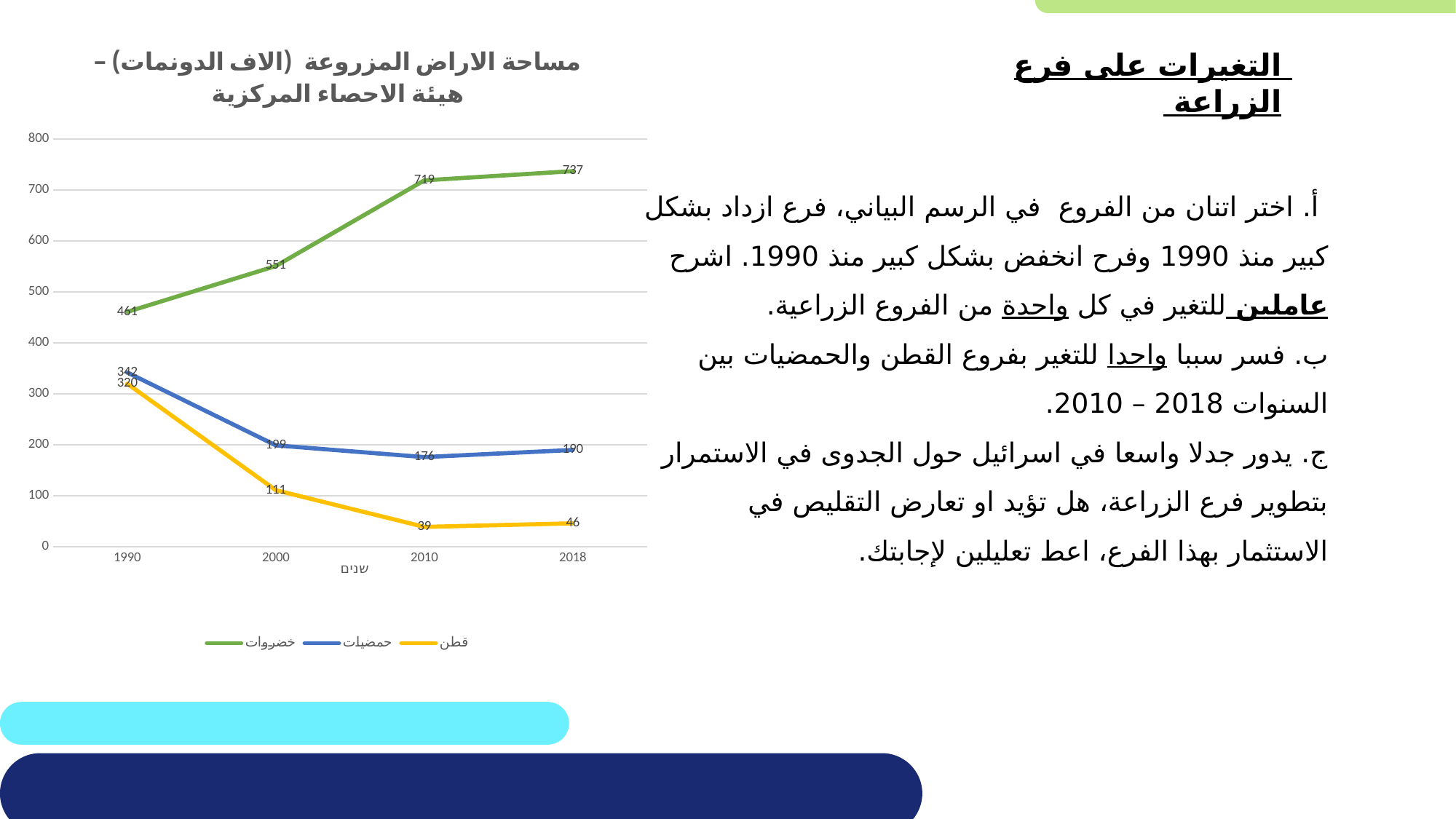
What is the value for حمضيات in 2000? 199 What is the value for قطن in 2010? 39 What is the value for خضروات in 2018? 737 What kind of chart is shown on the slide? Line chart Which series has the larger value in 1990, حمضيات or قطن? حمضيات In which year is the value for قطن lowest? 2010 Which series is drawn in green? خضروات How many years are plotted along the x axis? 4 Does the value for خضروات rise or fall from 1990 to 2018? Rise How many series does the chart legend list? 3 What is the difference between the خضروات value in 2018 and its value in 1990? 276 In which year is the value for خضروات highest? 2018